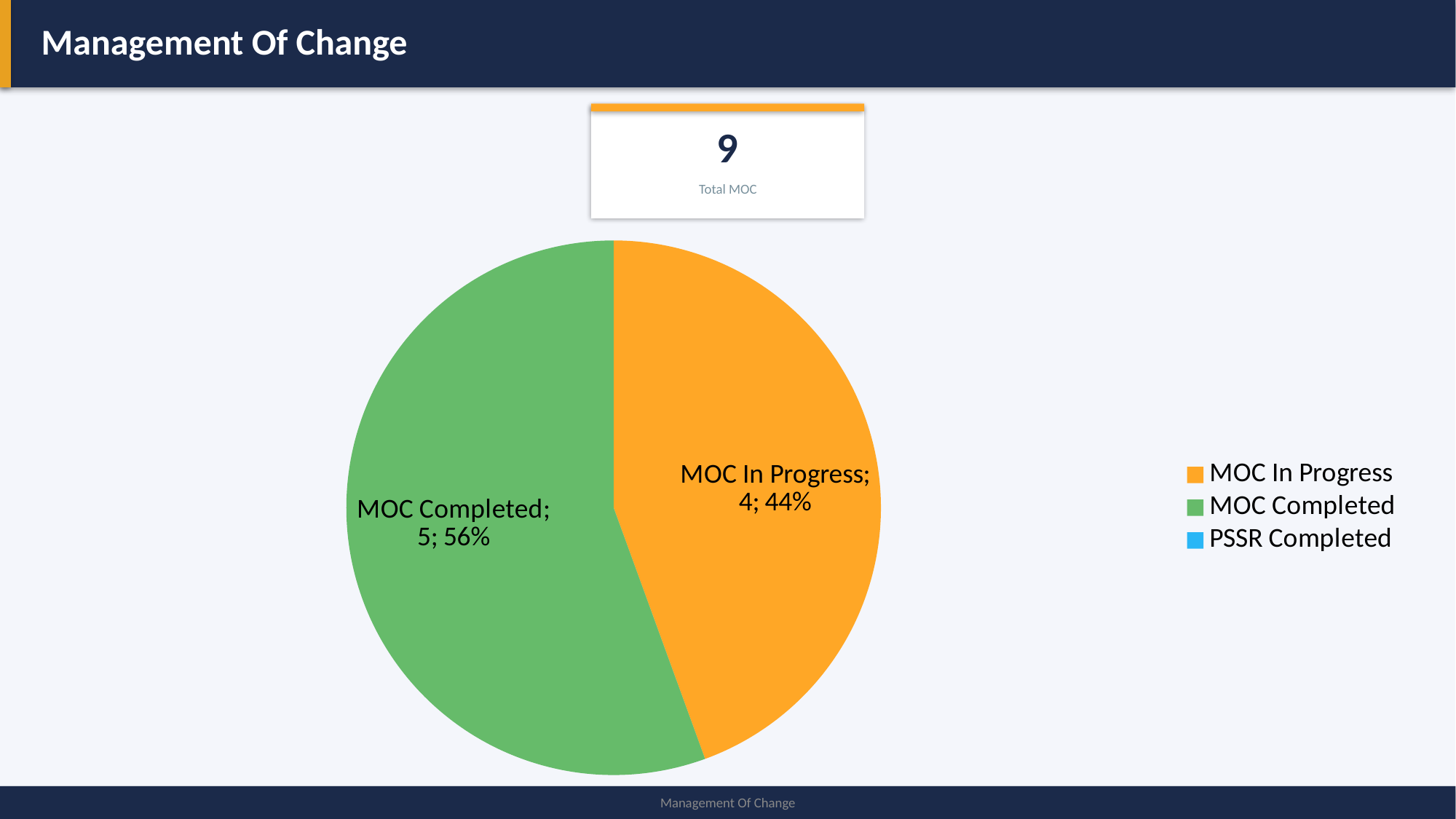
Which is larger, MOC In Progress or MOC Completed? MOC Completed What is the value for MOC In Progress? 4 What share of the pie does MOC Completed represent? 56% What kind of chart is shown on the slide? pie chart What is the value for MOC Completed? 5 How many entries does the legend list? 3 Which category has the largest slice of the pie? MOC Completed What share of the pie does MOC In Progress represent? 44% What is the Total MOC figure shown above the chart? 9 Which of the two labelled slices is smaller, MOC In Progress or MOC Completed? MOC In Progress What is the difference between the MOC Completed value and the MOC In Progress value? 1 What colour is the MOC In Progress slice? orange